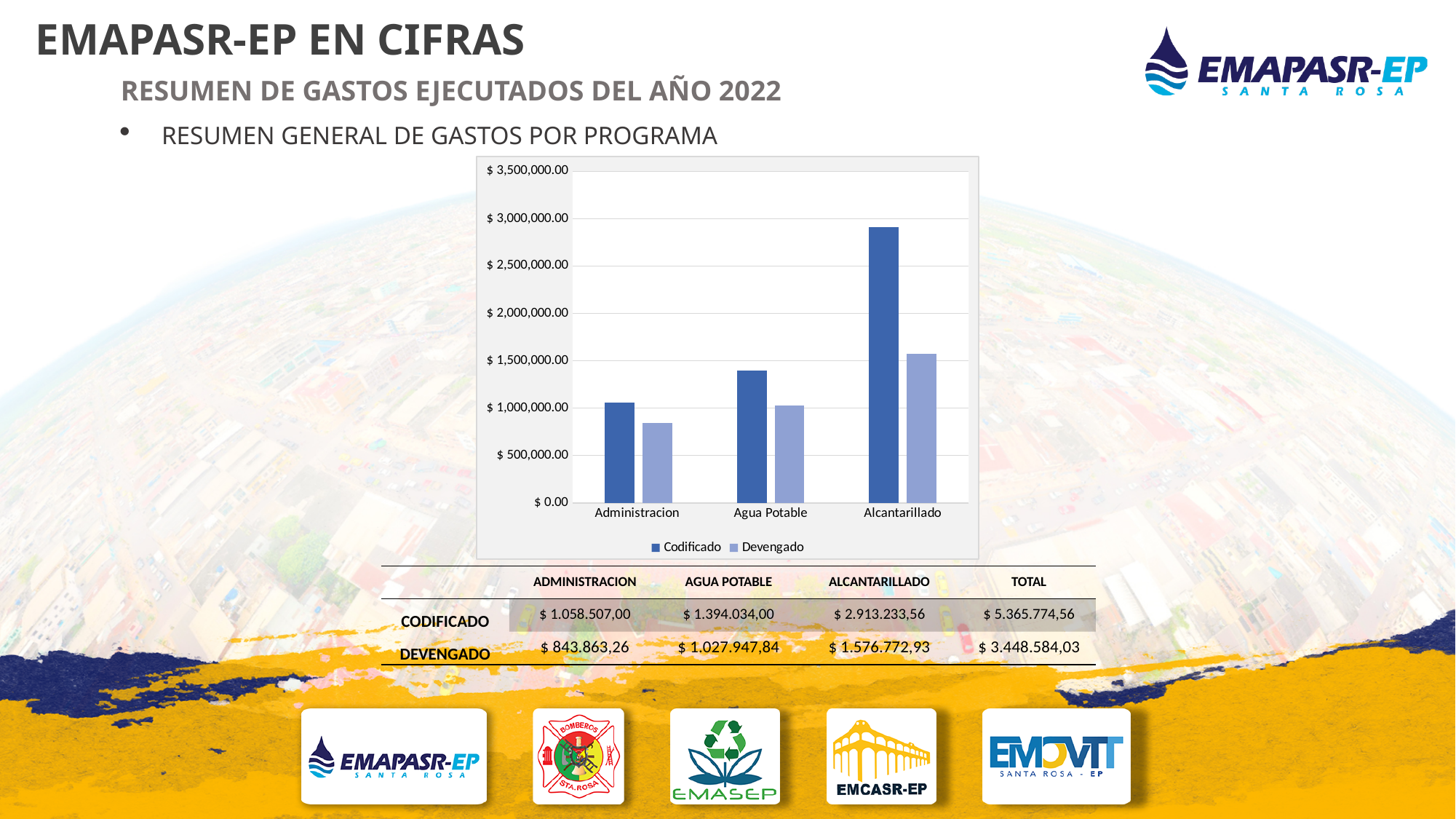
Which program has the lowest Devengado value? Administracion Which is larger: the Codificado value for Agua Potable or the Devengado value for Alcantarillado? Devengado for Alcantarillado Do the Codificado values rise or fall from Administracion to Alcantarillado? rise What is the Devengado value for Alcantarillado? $ 1.576.772,93 What is the total Codificado amount shown in the table? $ 5.365.774,56 What is the Codificado value for Administracion? $ 1.058.507,00 What is the difference between the Codificado and Devengado values for Agua Potable? $ 366.086,16 Which program has the highest Codificado value? Alcantarillado How many programs (categories) are shown on the x axis of the chart? 3 Is the Codificado value for Alcantarillado greater or less than $ 2,500,000.00? greater What kind of chart is shown on the slide? bar chart How many series does the chart legend list? 2